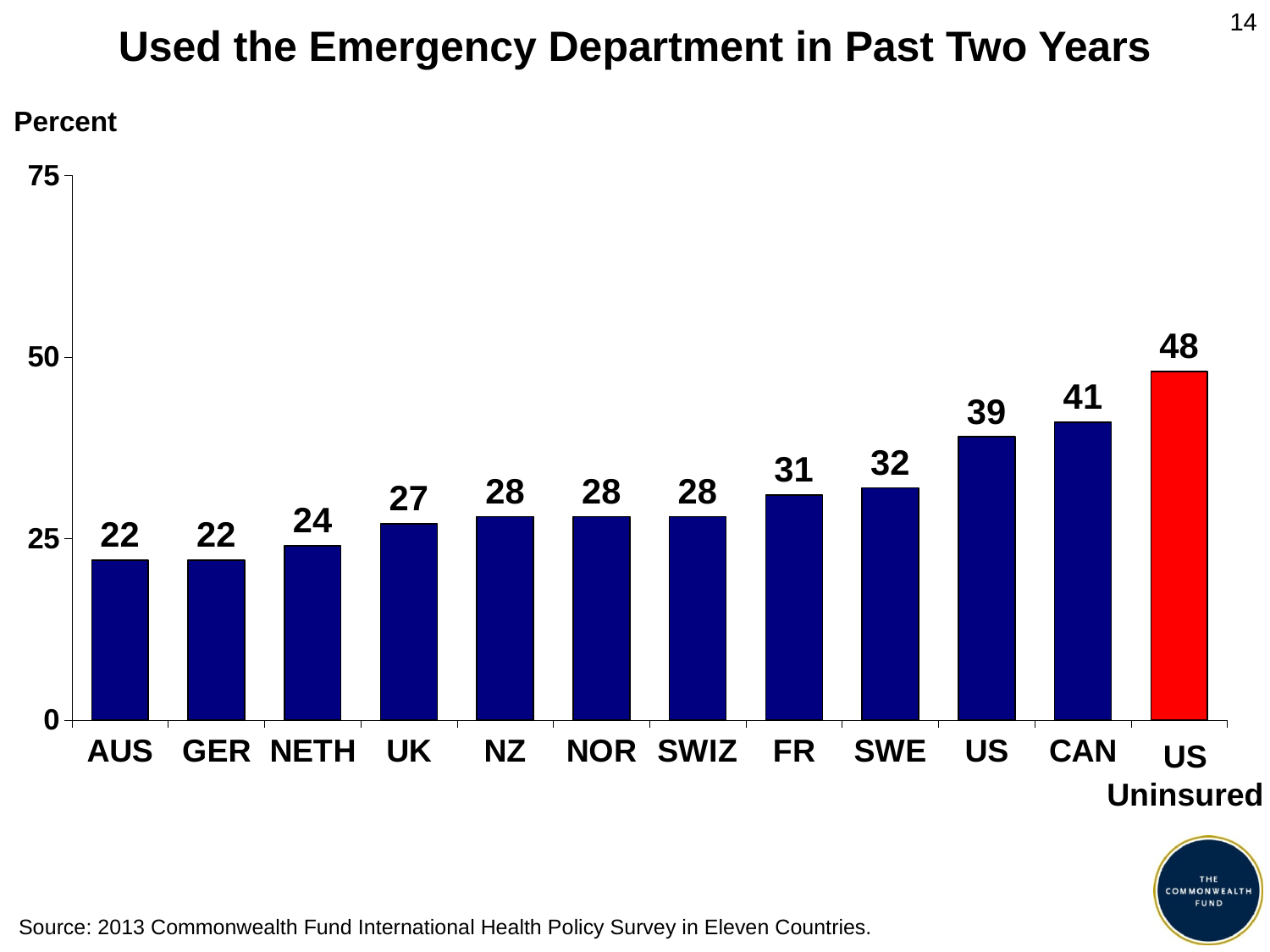
What is the value for CAN? 41 Is the value for CAN greater or less than 50? less What is the value for the US in the chart? 39 Which is larger, the value for FR or the value for NZ? FR What is the difference between the US Uninsured value and the US value? 9 What is the value for NETH? 24 Which bar is coloured red rather than dark blue? US Uninsured What kind of chart is shown on the slide? bar chart Which category has the highest value? US Uninsured How many categories are shown on the x axis? 12 Do the values generally rise or fall from left to right along the x axis? rise What is the difference between the values for SWE and UK? 5